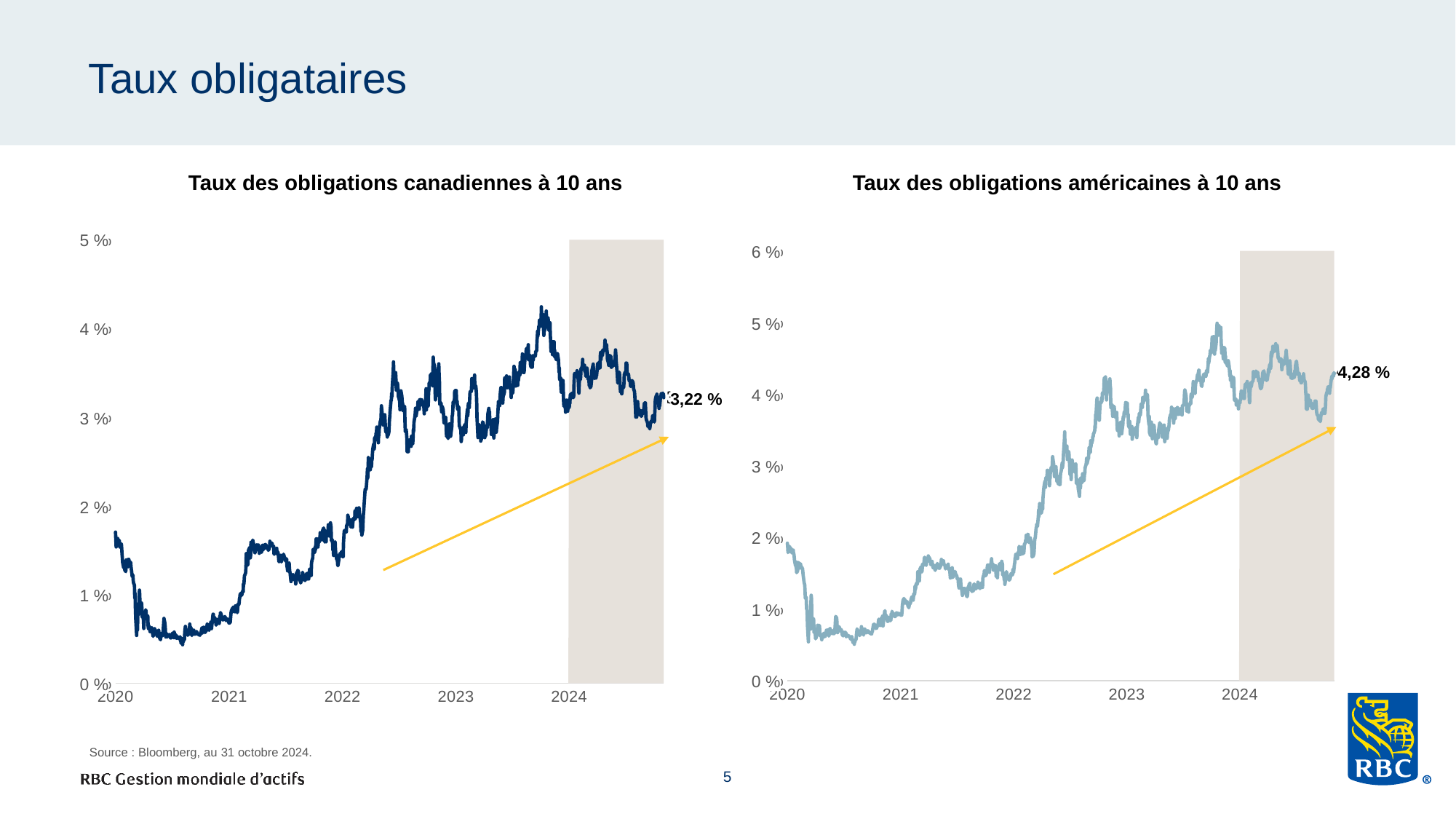
On the chart titled 'Taux des obligations canadiennes à 10 ans', what is the final value labelled at the end of the line? 3,22 % On the chart titled 'Taux des obligations canadiennes à 10 ans', is the value at the start of 2020 greater or less than 1 %? greater On the chart titled 'Taux des obligations américaines à 10 ans', do the values generally rise or fall from 2020 to 2024? rise What is the difference between the labelled end value on the American chart (4,28 %) and the labelled end value on the Canadian chart (3,22 %)? 1,06 % What is the title of the left-hand chart on the slide? Taux des obligations canadiennes à 10 ans What kind of chart is 'Taux des obligations canadiennes à 10 ans'? line chart On the chart titled 'Taux des obligations américaines à 10 ans', what is the final value labelled at the end of the line? 4,28 % Comparing the labelled end values, which chart shows the higher 10-year bond yield: the Canadian chart or the American chart? Taux des obligations américaines à 10 ans What is the highest value shown on the y axis of the chart titled 'Taux des obligations américaines à 10 ans'? 6 % How many year labels are shown on the x axis of the chart titled 'Taux des obligations canadiennes à 10 ans'? 5 On the chart titled 'Taux des obligations américaines à 10 ans', is the value at the start of 2022 greater or less than 2 %? less On the chart titled 'Taux des obligations canadiennes à 10 ans', is the lowest point of the line in 2020 greater or less than 1 %? less